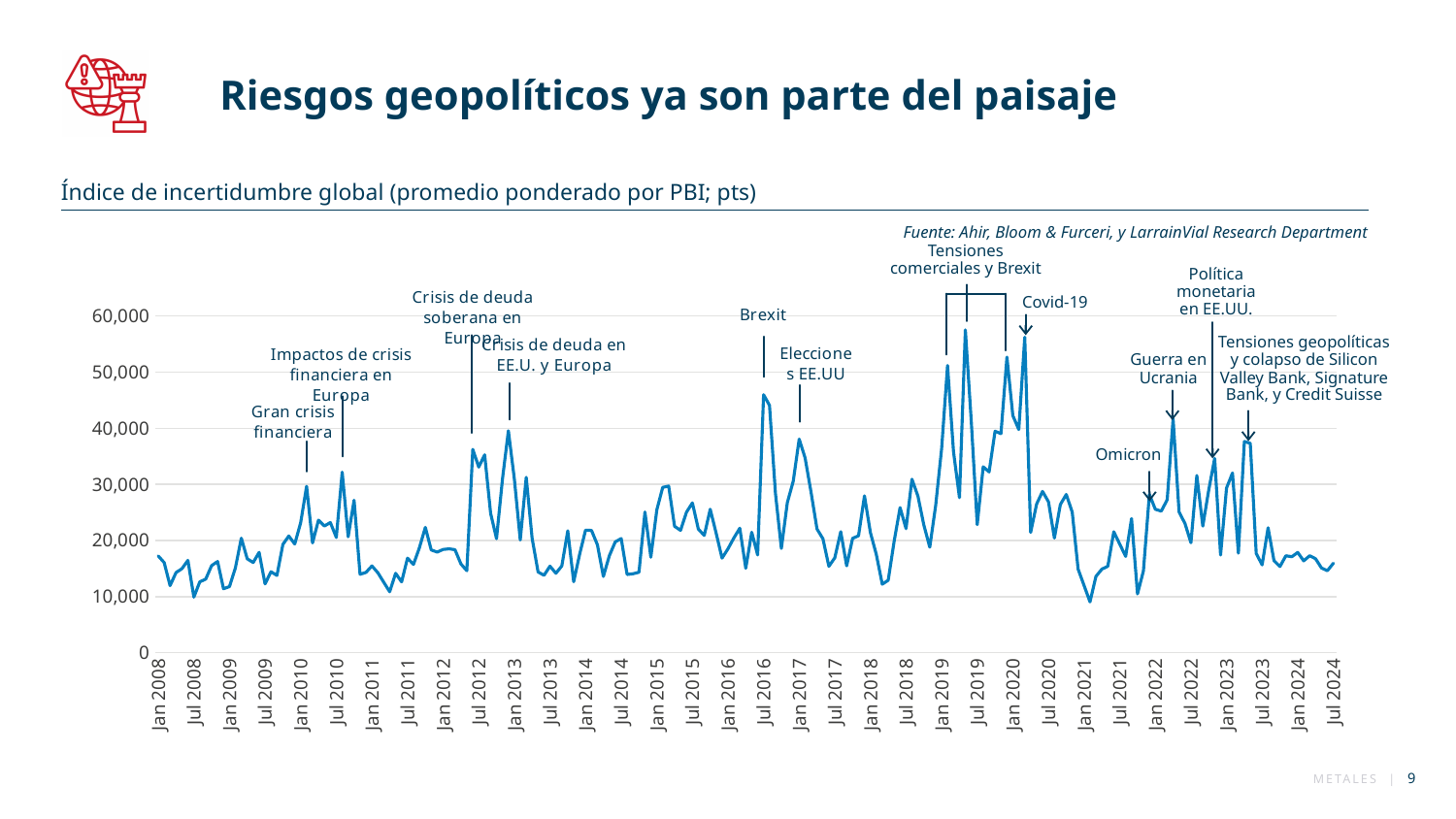
Which peak is higher, the Covid-19 peak or the Omicron peak? Covid-19 Is the value at the Gran crisis financiera peak greater or less than 20,000? greater Which peak is higher, the Brexit peak or the Gran crisis financiera peak? Brexit What is the title of the chart? Índice de incertidumbre global (promedio ponderado por PBI; pts) What kind of chart is shown on the slide? line chart Does the index generally rise or fall between Jan 2023 and Jul 2024? fall How many data series are plotted on the chart? 1 Is the value at the Omicron peak greater or less than 40,000? less Is the value at the Covid-19 peak greater or less than 50,000? greater Which event is annotated at the peak around Jan 2022? Guerra en Ucrania